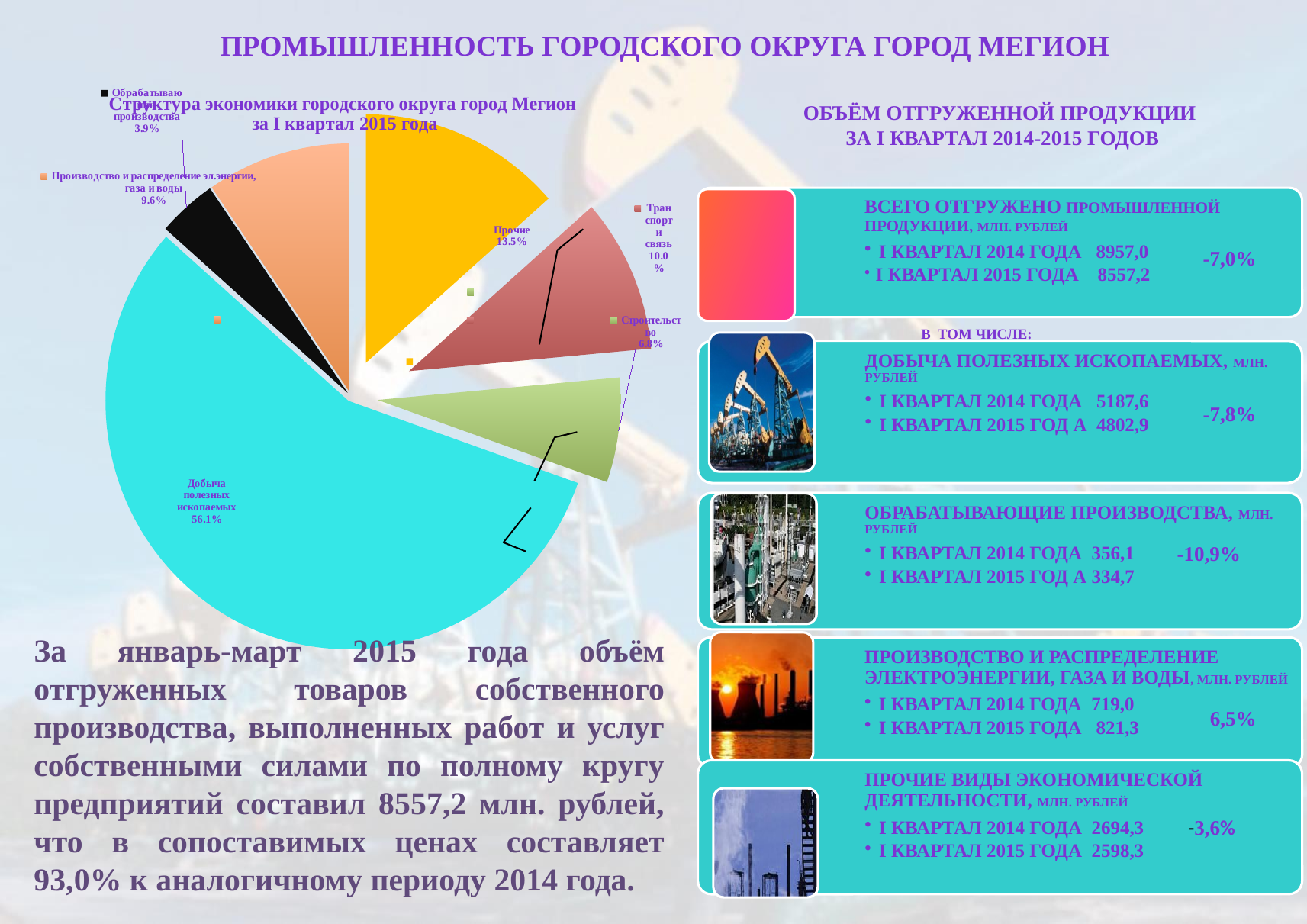
What is the title of the pie chart? Структура экономики городского округа город Мегион за I квартал 2015 года What share of the pie does "Производство и распределение эл.энергии, газа и воды" have? 9.6% How many slices does the pie chart have? 6 What share of the pie does "Транспорт и связь" have? 10.0% What kind of chart is shown on the slide? Pie chart What share of the pie does "Добыча полезных ископаемых" have? 56.1% Which category has the largest slice of the pie? Добыча полезных ископаемых What share of the pie does "Прочие" have? 13.5% Which category has the smallest slice of the pie? Обрабатывающие производства What share of the pie does "Обрабатывающие производства" have? 3.9% Which slice is larger: "Прочие" or "Транспорт и связь"? Прочие What is the difference in percentage points between "Добыча полезных ископаемых" and "Прочие"? 42.6